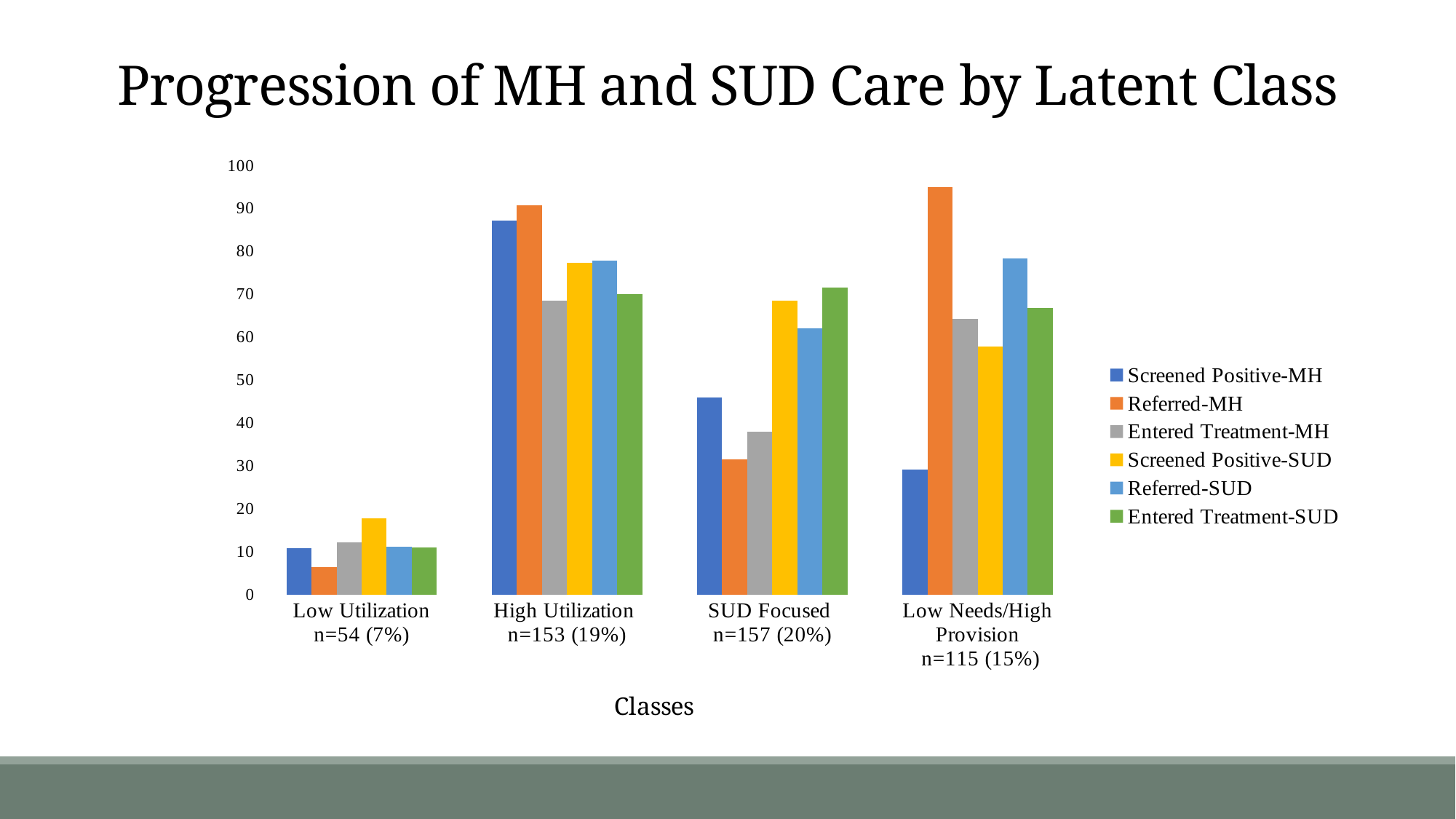
What kind of chart is shown on the slide? bar chart How many latent classes are shown along the x axis? 4 How many series does the legend list? 6 Which class has the lowest Screened Positive-MH value? Low Utilization Is the Screened Positive-MH value for High Utilization greater or less than 80? greater Which series has the lowest value for the Low Utilization class? Referred-MH Is the Referred-SUD value for Low Needs/High Provision greater or less than 70? greater What is the title of the x axis? Classes Which series has the highest value for the Low Needs/High Provision class? Referred-MH For the SUD Focused class, which is larger: Screened Positive-MH or Screened Positive-SUD? Screened Positive-SUD Is the Referred-MH value for SUD Focused greater or less than 40? less For the Low Needs/High Provision class, which is larger: Referred-MH or Screened Positive-MH? Referred-MH